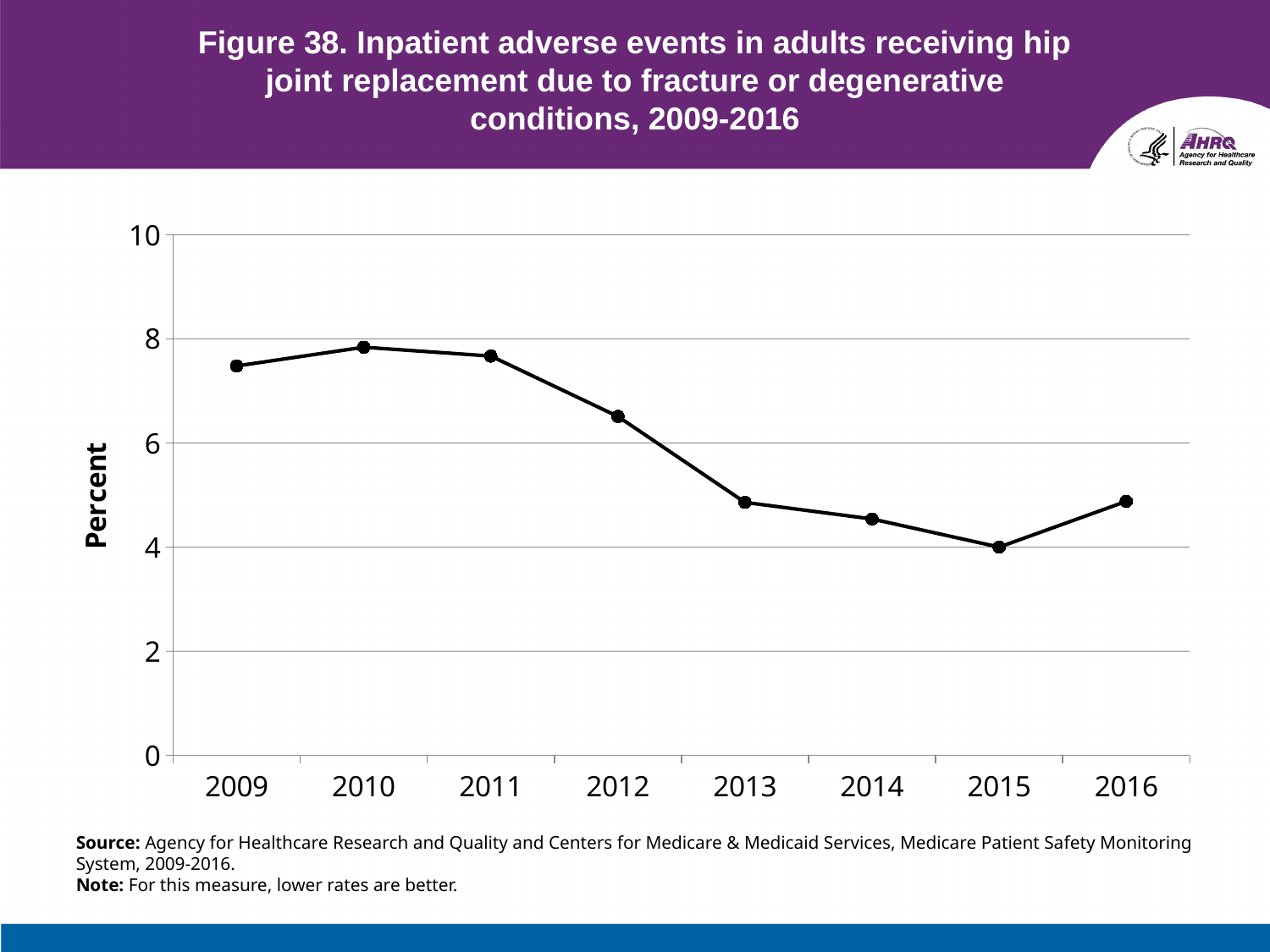
Overall, do the values rise or fall from 2009 to 2016? fall What is the label on the y axis? Percent How many years are plotted on the x axis? 8 Which year has the lowest percent of inpatient adverse events? 2015 Which is larger, the value for 2012 or the value for 2015? 2012 Is the value for 2014 greater or less than 4? greater Is the value for 2012 greater or less than 6? greater Is the value for 2013 greater or less than 6? less What kind of chart is shown on the slide? line chart Which is larger, the value for 2009 or the value for 2013? 2009